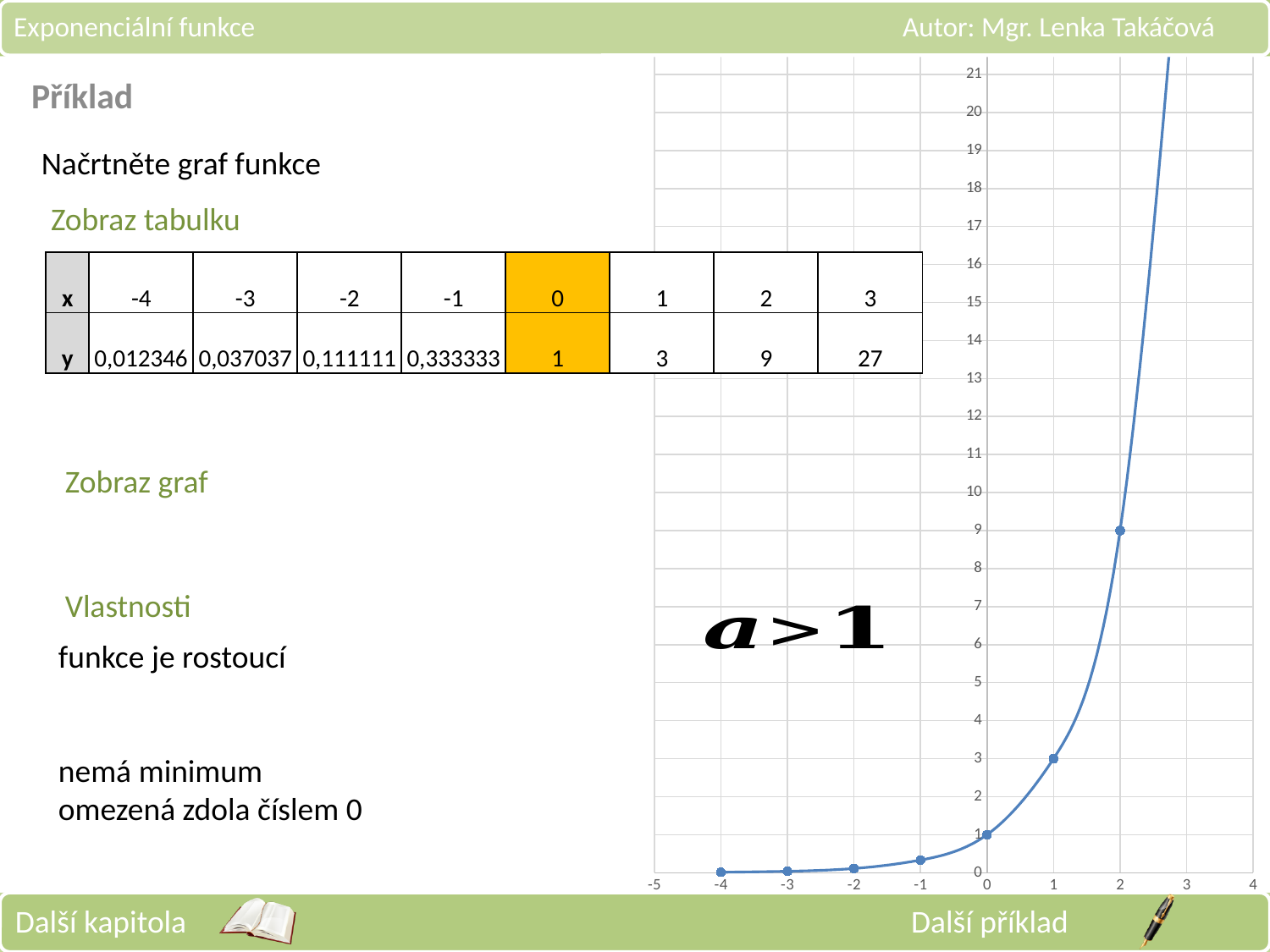
What is the highest tick label shown on the y axis of the chart? 21 What is the value of y at x = 0? 1 Is the value of y at x = 2 greater or less than 5? greater What is the value of y at x = -1 according to the table? 0,333333 Is the value of y at x = -2 greater or less than 1? less Which is larger, the y value at x = 1 or at x = -1? x = 1 What is the value of y at x = 1? 3 What is the value of y at x = 2? 9 Do the plotted values rise or fall as x increases along the x axis? rise What is the difference between the y values at x = 2 and x = 1? 6 What kind of chart is shown on the right of the slide? line chart What is the value of y at x = 3 according to the table? 27